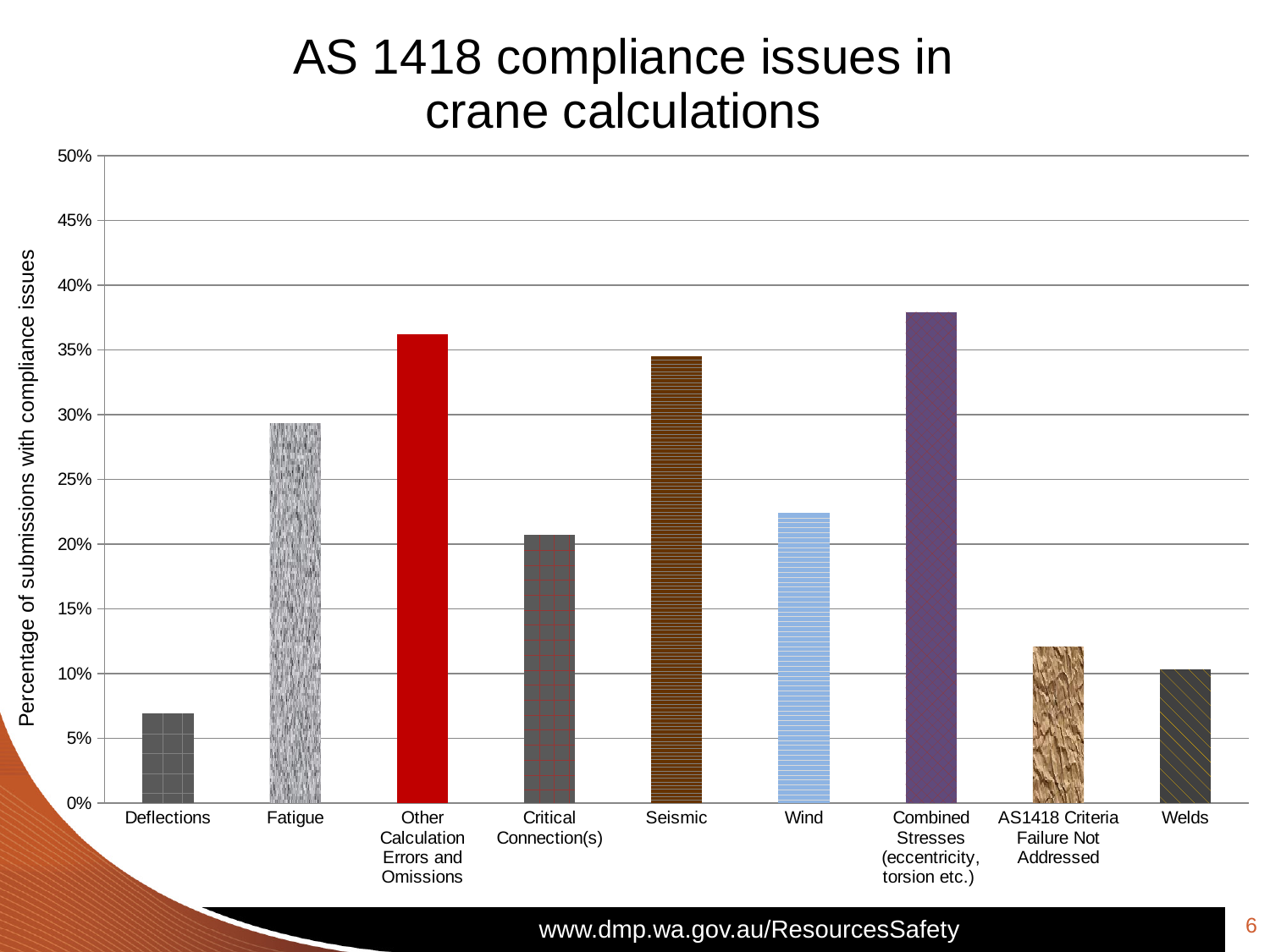
Which category has the highest percentage of submissions with compliance issues? Combined Stresses (eccentricity, torsion etc.) Which has a higher percentage of submissions with compliance issues, Seismic or Wind? Seismic Is the value for Welds greater or less than 15%? less Is the value for Combined Stresses (eccentricity, torsion etc.) greater or less than 40%? less What kind of chart is shown on the slide? bar chart Is the value for Fatigue greater or less than 25%? greater Which category has the lowest percentage of submissions with compliance issues? Deflections What is the label on the vertical axis of the chart? Percentage of submissions with compliance issues How many compliance issue categories are shown on the x axis? 9